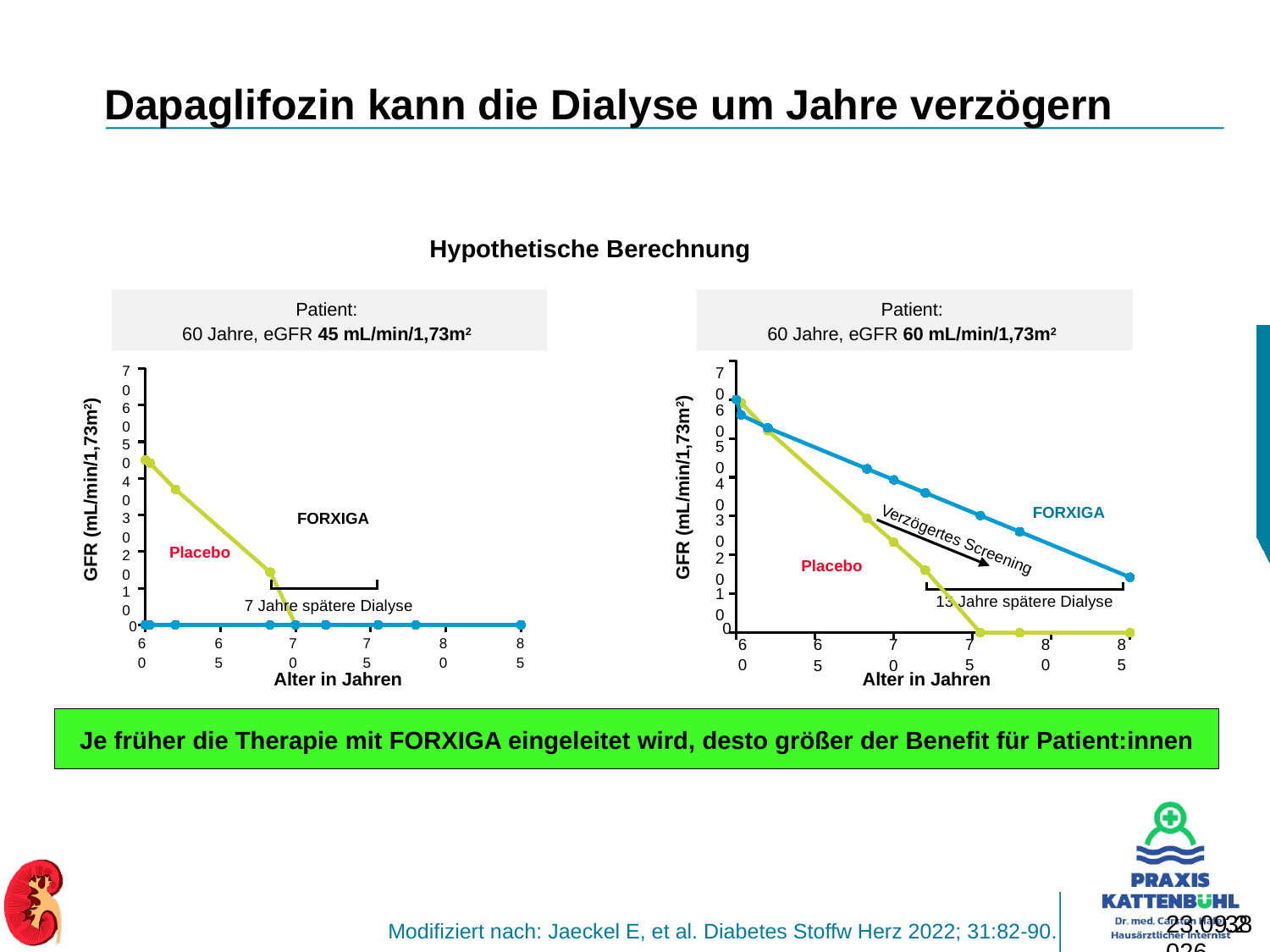
In the right chart (eGFR 60), which series has the higher GFR at age 75, Placebo or FORXIGA? FORXIGA In the right chart (eGFR 60), is the Placebo GFR value at age 70 greater or less than 30? less In the right chart (Patient 60 Jahre, eGFR 60 mL/min/1,73m²), how many series are plotted? 2 What kind of chart is shown on the left (Patient 60 Jahre, eGFR 45 mL/min/1,73m²)? line chart In the right chart (eGFR 60), which series reaches a GFR of 0 first, Placebo or FORXIGA? Placebo In the right chart (eGFR 60), does the FORXIGA line rise or fall as age increases? falls What is the x-axis title of the left chart (eGFR 45)? Alter in Jahren In the left chart (eGFR 45), is the Placebo GFR value at age 65 greater or less than 40? less In the right chart (eGFR 60), is the FORXIGA GFR value at age 85 greater or less than 20? less In the left chart (eGFR 45), does the Placebo line rise or fall as age increases? falls What annotation is written under the bracket in the left chart (eGFR 45)? 7 Jahre spätere Dialyse